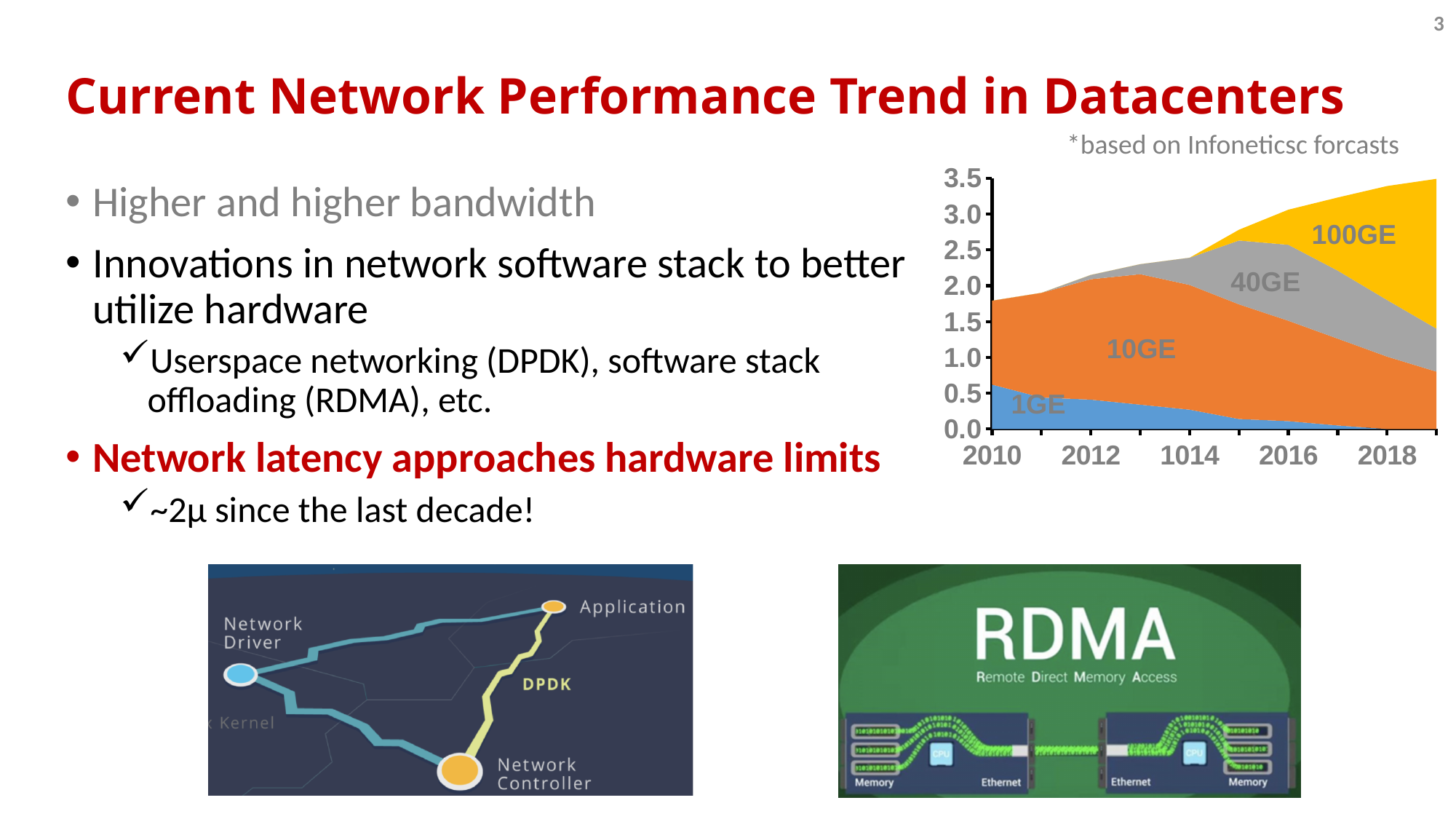
Which series has the largest share in 2018? 100GE Which series has the largest share in 2010? 10GE How many series (bandwidth categories) are labelled in the chart? 4 Is the value for 1GE in 2010 greater or less than 0.5? greater Is the total stacked value in 2018 greater or less than 3.0? greater Does the 100GE area rise or fall toward 2018? rise How many year labels are shown on the x axis of the chart? 5 Is the total stacked value in 2010 greater or less than 2.0? less What colour is the 100GE area in the chart? yellow Which series has the smallest share in 2018? 1GE Does the 1GE area rise or fall from 2010 to 2018? fall What kind of chart is shown on the slide? stacked area chart